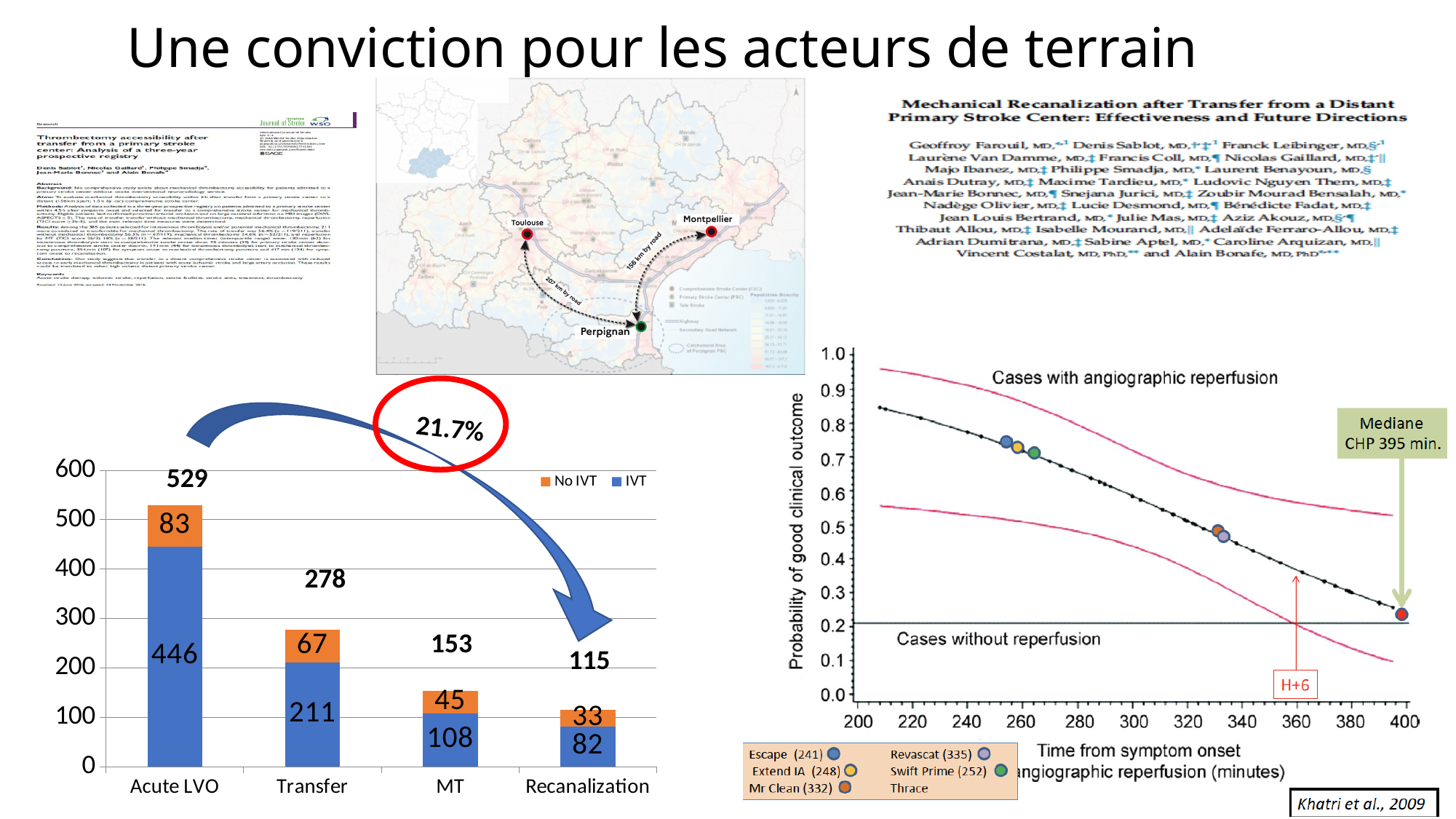
In the stacked bar chart on the bottom left, what is the No IVT value for Transfer? 67 In the stacked bar chart on the bottom left, what is the IVT value for Acute LVO? 446 In the stacked bar chart on the bottom left, what is the difference between the IVT values for Transfer and MT? 103 In the stacked bar chart on the bottom left, which category has the highest total? Acute LVO In the line chart on the right (Khatri et al., 2009), is the probability of good clinical outcome at 400 minutes greater or less than 0.3? less In the stacked bar chart on the bottom left, how many series does the legend list? 2 In the stacked bar chart on the bottom left, do the bar totals rise or fall from Acute LVO to Recanalization? fall In the stacked bar chart on the bottom left, what is the total of the Transfer bar? 278 In the stacked bar chart on the bottom left, which is larger: the No IVT value for MT or the No IVT value for Recanalization? No IVT value for MT In the stacked bar chart on the bottom left, what is the IVT value for MT? 108 In the stacked bar chart on the bottom left, what is the total of the Recanalization bar? 115 In the stacked bar chart on the bottom left, which category has the lowest total? Recanalization